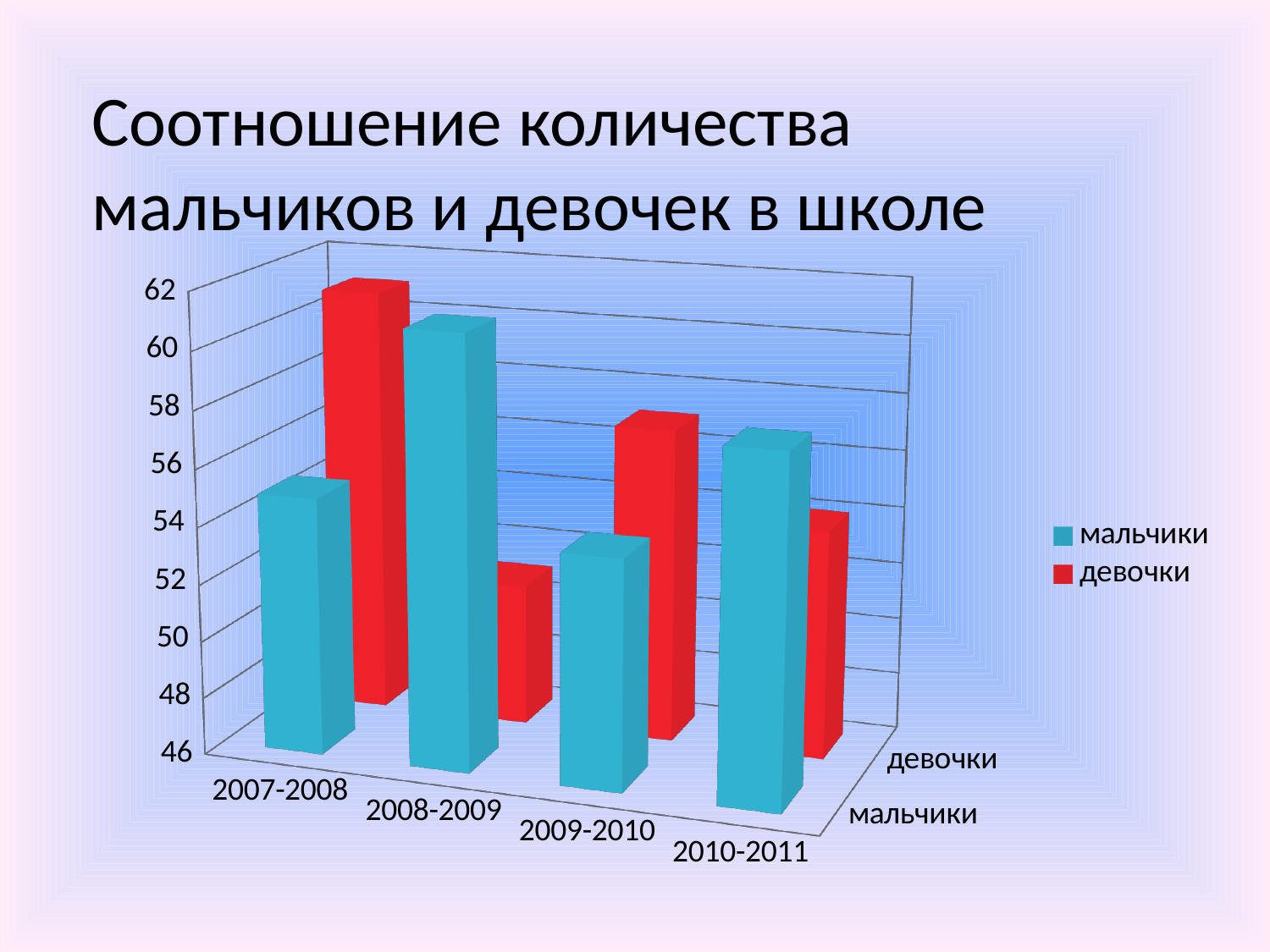
What kind of chart is shown on the slide? bar chart How many school-year categories are shown on the x axis? 4 In 2007-2008, which is larger: мальчики or девочки? девочки In 2008-2009, which is larger: мальчики or девочки? мальчики Is the value for мальчики in 2008-2009 greater or less than 58? greater In which school year is the value for мальчики the lowest? 2009-2010 How many series does the legend list? 2 In which school year is the value for мальчики the highest? 2008-2009 In which school year is the value for девочки the highest? 2007-2008 In which school year is the value for девочки the lowest? 2008-2009 Which colour represents девочки in the chart? red Is the value for мальчики in 2009-2010 greater or less than 56? less